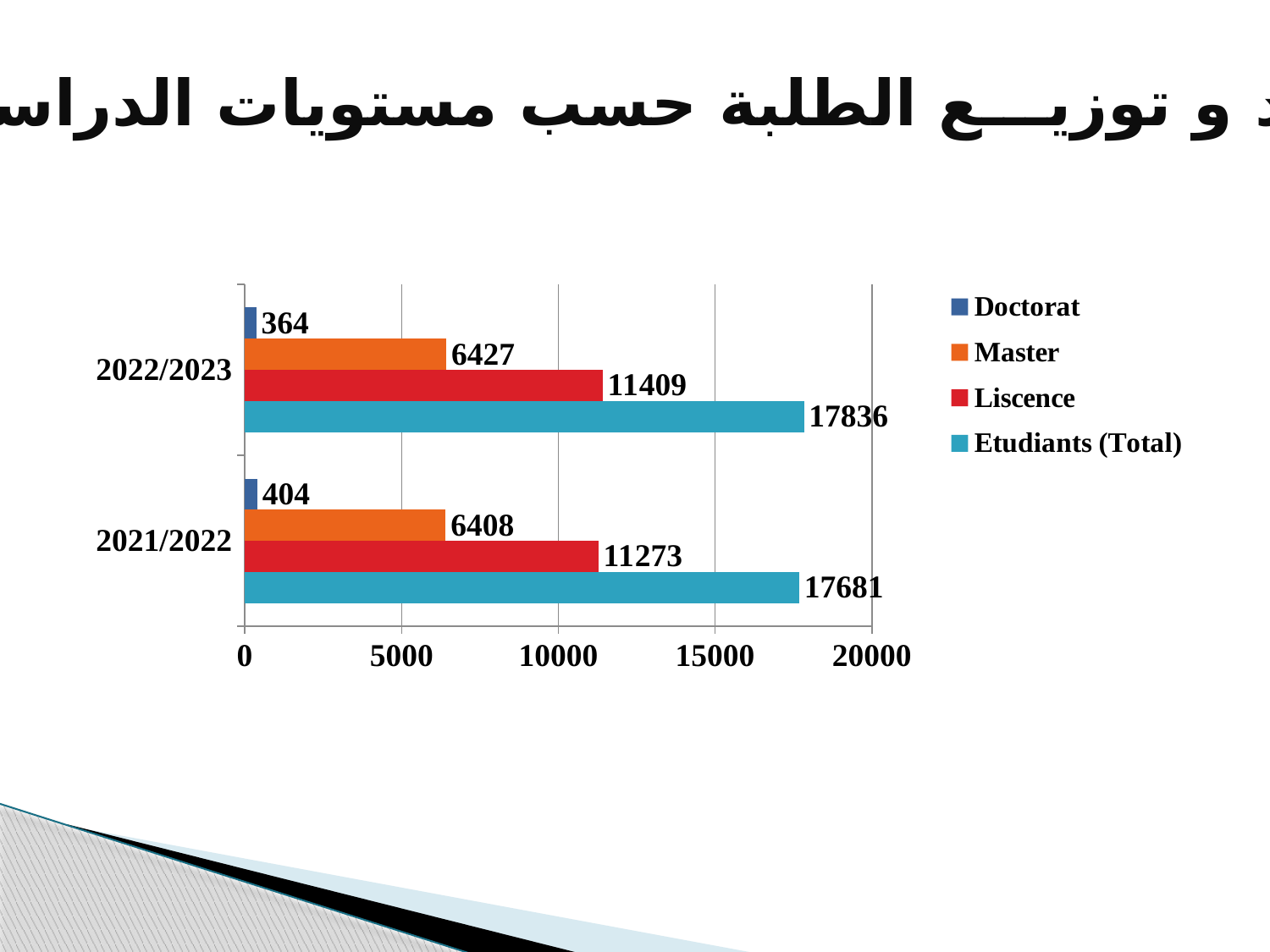
What is the value for Doctorat in 2022/2023? 364 What is the value for Liscence in 2022/2023? 11409 How many series does the legend list? 4 What is the value for Master in 2021/2022? 6408 Which series has the highest value in 2022/2023? Etudiants (Total) Which series has the lowest value in 2021/2022? Doctorat What kind of chart is shown on the slide? Bar chart What is the value for Etudiants (Total) in 2021/2022? 17681 How many academic years are shown on the chart? 2 Which is larger: Doctorat in 2021/2022 or Doctorat in 2022/2023? Doctorat in 2021/2022 What is the difference between Etudiants (Total) in 2022/2023 and 2021/2022? 155 What is the difference between the Liscence values for 2022/2023 and 2021/2022? 136